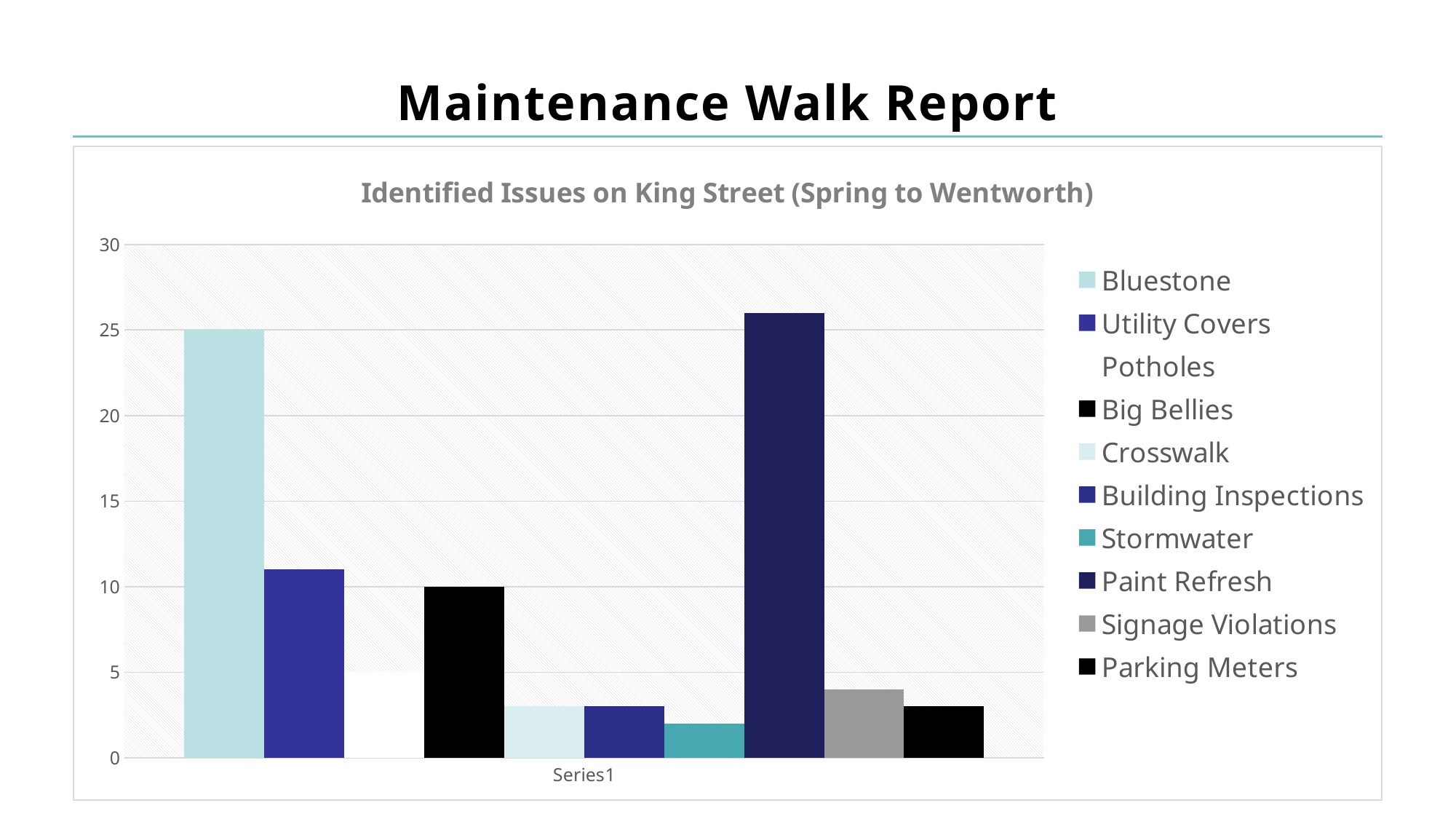
Is the value for Utility Covers greater or less than 10? greater Which is larger, the value for Bluestone or the value for Utility Covers? Bluestone What kind of chart is shown on the slide? bar chart What is the title of the chart? Identified Issues on King Street (Spring to Wentworth) Is the value for Paint Refresh greater or less than 25? greater Is the value for Signage Violations greater or less than 5? less How many series does the legend list? 10 What is the difference between the values for Bluestone and Big Bellies? 15 What is the value for Bluestone? 25 Which is larger, the value for Big Bellies or the value for Stormwater? Big Bellies What is the value for Big Bellies? 10 Which series has the highest value? Paint Refresh